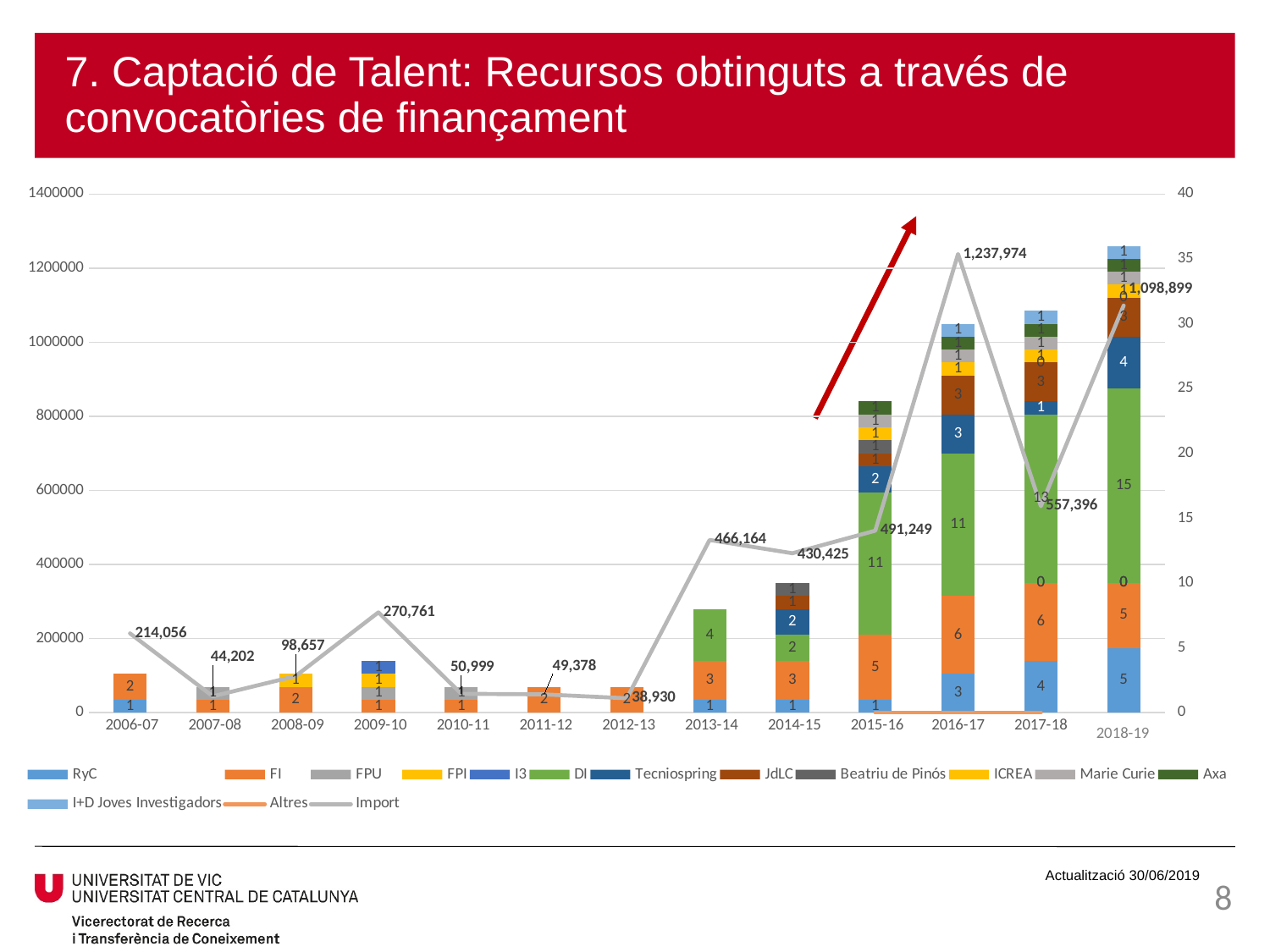
Which year has the lowest Import value? 2012-13 Which year has the highest Import value? 2016-17 Which is larger, the Import value for 2006-07 or for 2009-10? 2009-10 What is the Import value for 2012-13? 38,930 What is the value of the DI segment in the 2018-19 bar? 15 What is the value of the FI segment in the 2016-17 bar? 6 How many entries does the legend list? 15 What is the difference between the Import values for 2016-17 and 2018-19? 139,075 What is the difference between the Import values for 2013-14 and 2014-15? 35,739 How many years are shown on the x axis? 13 What is the Import value for 2018-19? 1,098,899 What is the Import value for 2016-17? 1,237,974